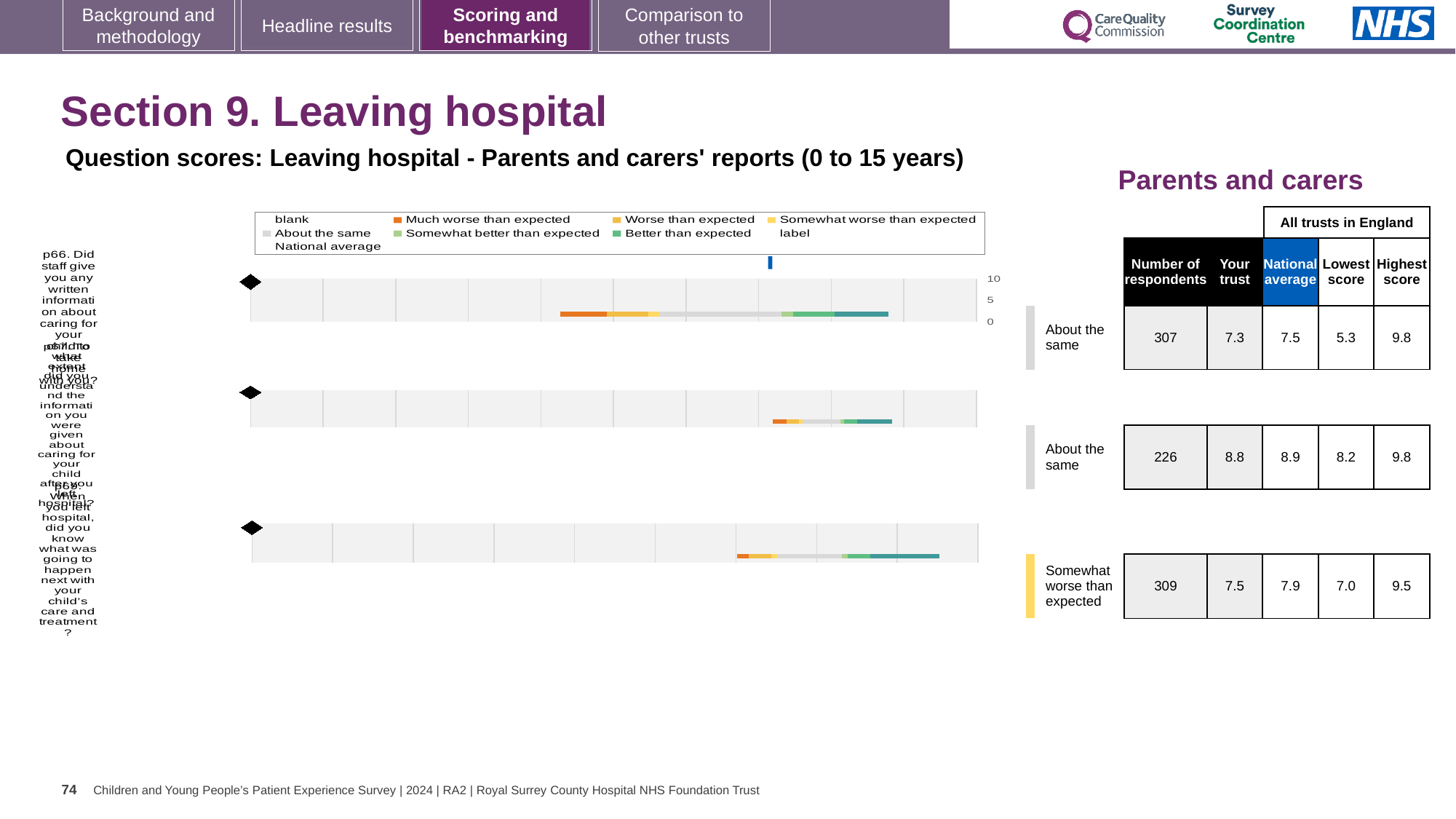
In the Parents and carers table, what is the 'Your trust' score for the row with 307 respondents? 7.3 In the Parents and carers table, which row has the highest 'Your trust' score? the row with 226 respondents (8.8) In the Parents and carers table, what is the lowest score for the row labelled 'Somewhat worse than expected'? 7.0 How many separate benchmark bar charts are shown on the slide? 3 What kind of chart is used to show the question scores on this slide? bar chart What is the highest tick value shown on the axis of the top bar chart? 10 In the legend, which colour represents 'Much worse than expected'? orange In the Parents and carers table, what is the difference between the national average and the 'Your trust' score for the row labelled 'Somewhat worse than expected'? 0.4 In the Parents and carers table, for the row with 307 respondents, which is larger: the 'Your trust' score or the national average? National average In the Parents and carers table, what is the highest score for the row with 309 respondents? 9.5 How many entries does the legend above the bar charts list? 9 In the Parents and carers table, what is the national average for the row with 226 respondents? 8.9